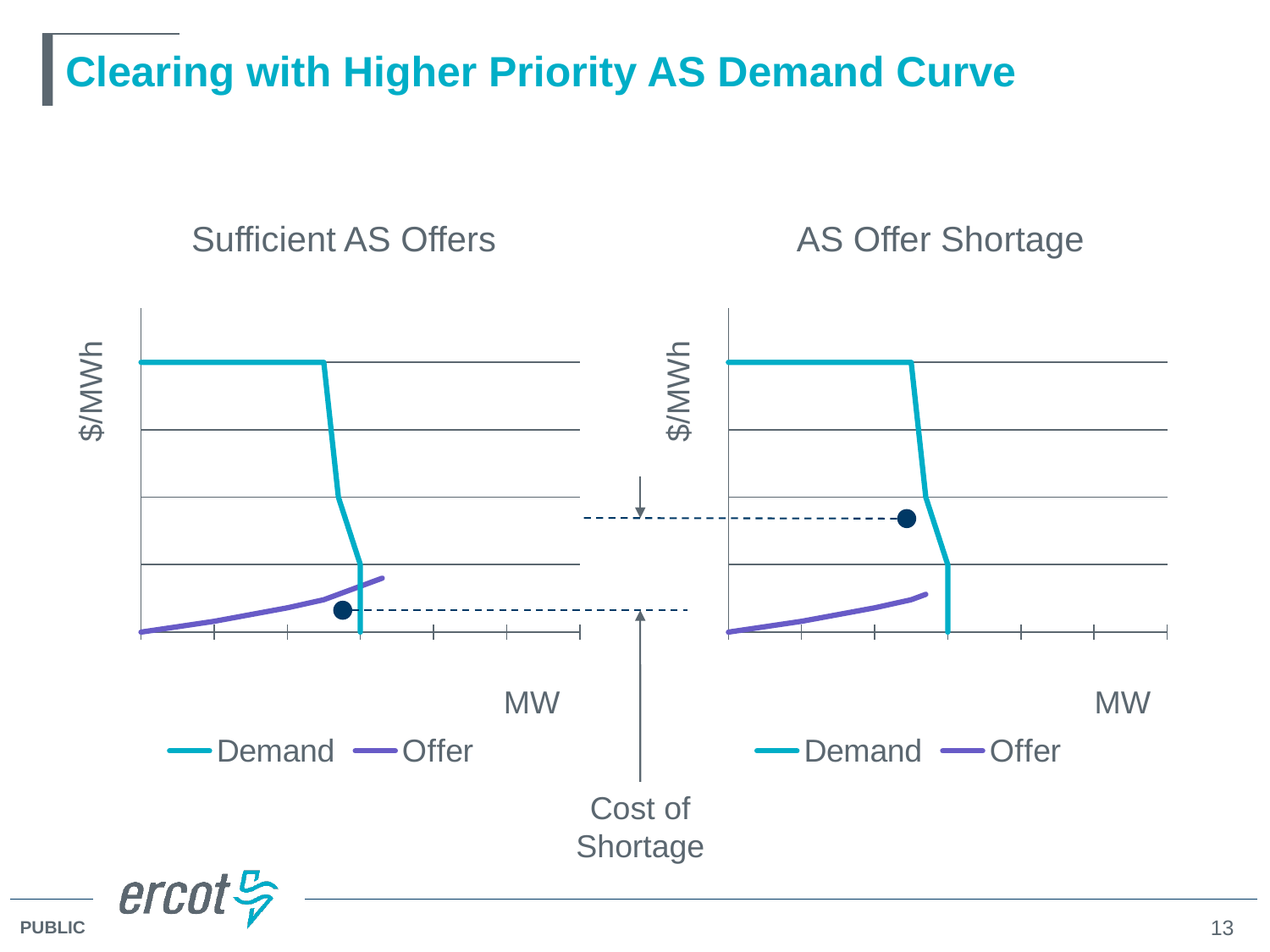
In the 'Sufficient AS Offers' chart, how many series does the legend list? 2 In the 'Sufficient AS Offers' chart, does the Demand curve rise or fall as MW increases? fall In the 'Sufficient AS Offers' chart, what kind of chart is shown? line chart In the 'Sufficient AS Offers' chart, which series is drawn in purple? Offer In the 'AS Offer Shortage' chart, what kind of chart is shown? line chart In the 'AS Offer Shortage' chart, what is the label on the vertical axis? $/MWh In the 'Sufficient AS Offers' chart, does the Offer curve rise or fall as MW increases? rise In the 'AS Offer Shortage' chart, how many series does the legend list? 2 In the 'AS Offer Shortage' chart, does the Offer curve rise or fall as MW increases? rise